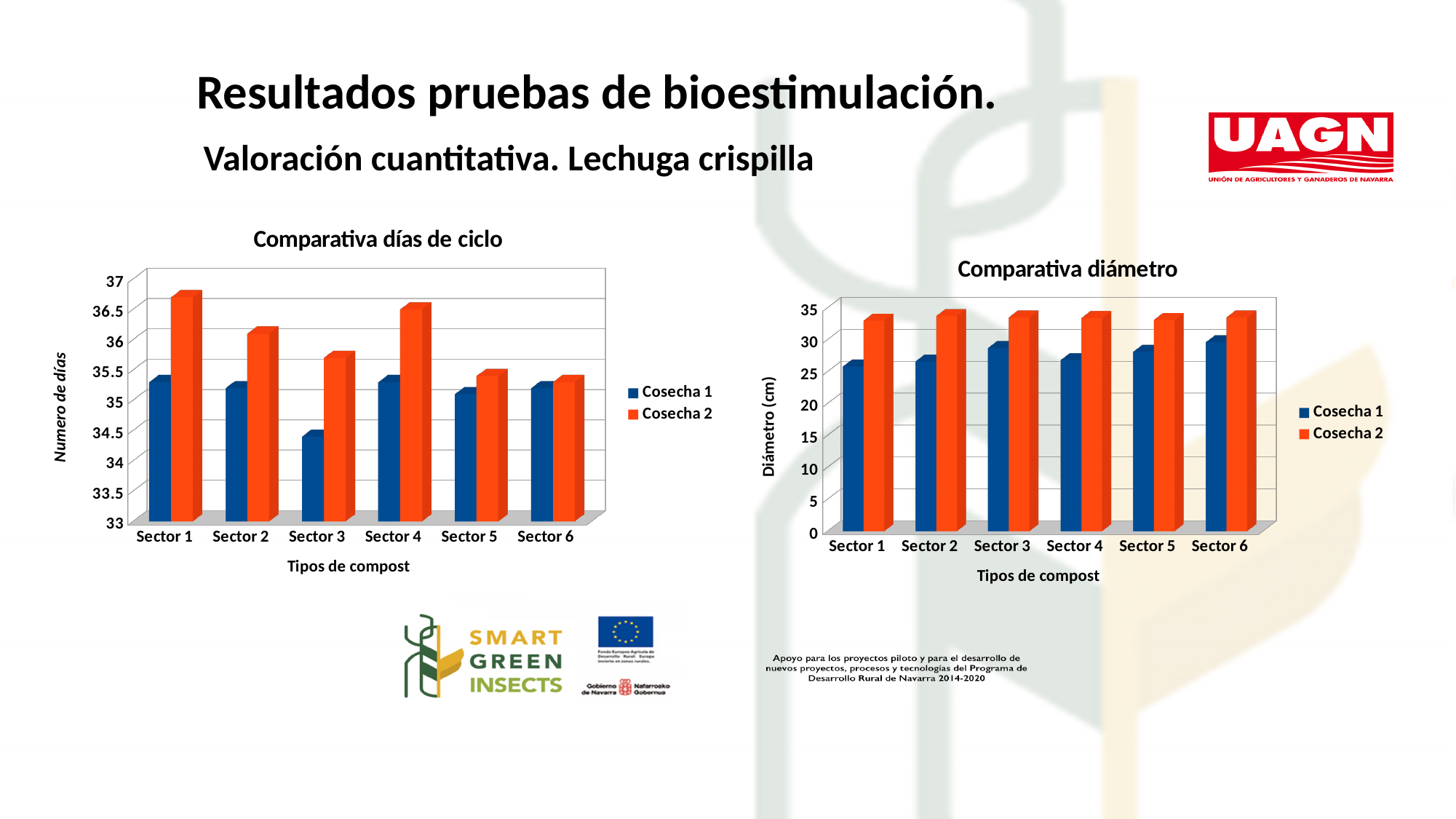
In the 'Comparativa días de ciclo' chart, which sector has the lowest Cosecha 1 value? Sector 3 In the 'Comparativa diámetro' chart, is the Cosecha 2 value for Sector 2 greater or less than 30? greater In the 'Comparativa diámetro' chart, which is larger: the Cosecha 1 value for Sector 6 or the Cosecha 1 value for Sector 1? Sector 6 In the 'Comparativa días de ciclo' chart, is the Cosecha 2 value for Sector 1 greater or less than 36? greater In the 'Comparativa diámetro' chart, which sector has the highest Cosecha 1 value? Sector 6 In the 'Comparativa días de ciclo' chart, how many sectors are shown on the x axis? 6 In the 'Comparativa diámetro' chart, how many series does the legend list? 2 What kind of chart is 'Comparativa días de ciclo'? Bar chart In the 'Comparativa días de ciclo' chart, is the Cosecha 1 value for Sector 3 greater or less than 35? less In the 'Comparativa días de ciclo' chart, which is larger for Sector 4: Cosecha 1 or Cosecha 2? Cosecha 2 What is the y-axis title of the 'Comparativa diámetro' chart? Diámetro (cm)